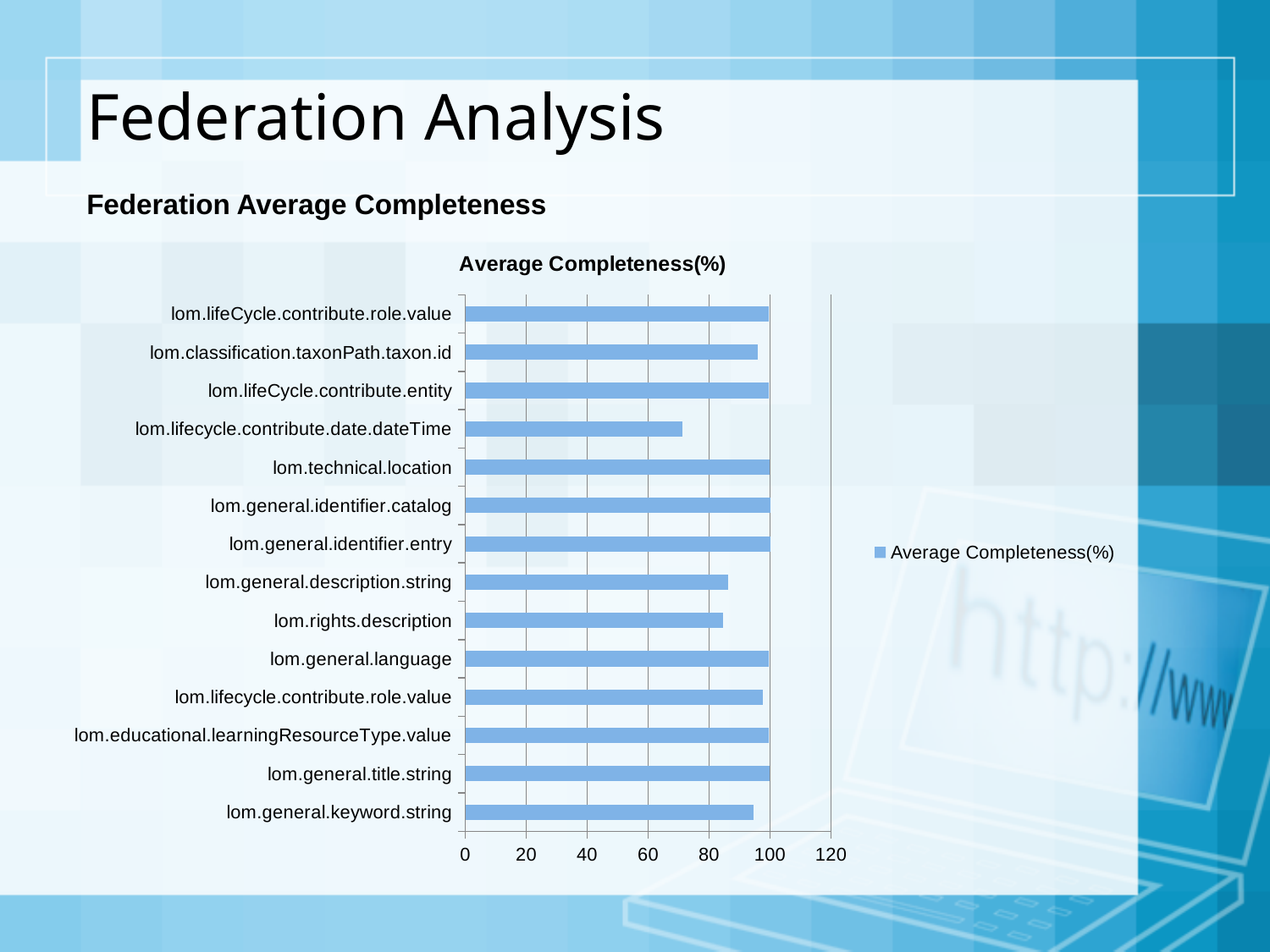
Is the value for lom.rights.description greater or less than 80? greater Which is larger, the value for lom.general.keyword.string or the value for lom.rights.description? lom.general.keyword.string Is the value for lom.lifecycle.contribute.date.dateTime greater or less than 60? greater What is the name of the series shown in the legend? Average Completeness(%) Which category has the lowest average completeness? lom.lifecycle.contribute.date.dateTime Is the value for lom.lifecycle.contribute.date.dateTime greater or less than 80? less Which is larger, the value for lom.technical.location or the value for lom.lifecycle.contribute.date.dateTime? lom.technical.location How many series does the legend list? 1 How many categories are plotted in the chart? 14 What kind of chart is shown on the slide? bar chart What is the title of the chart? Average Completeness(%)